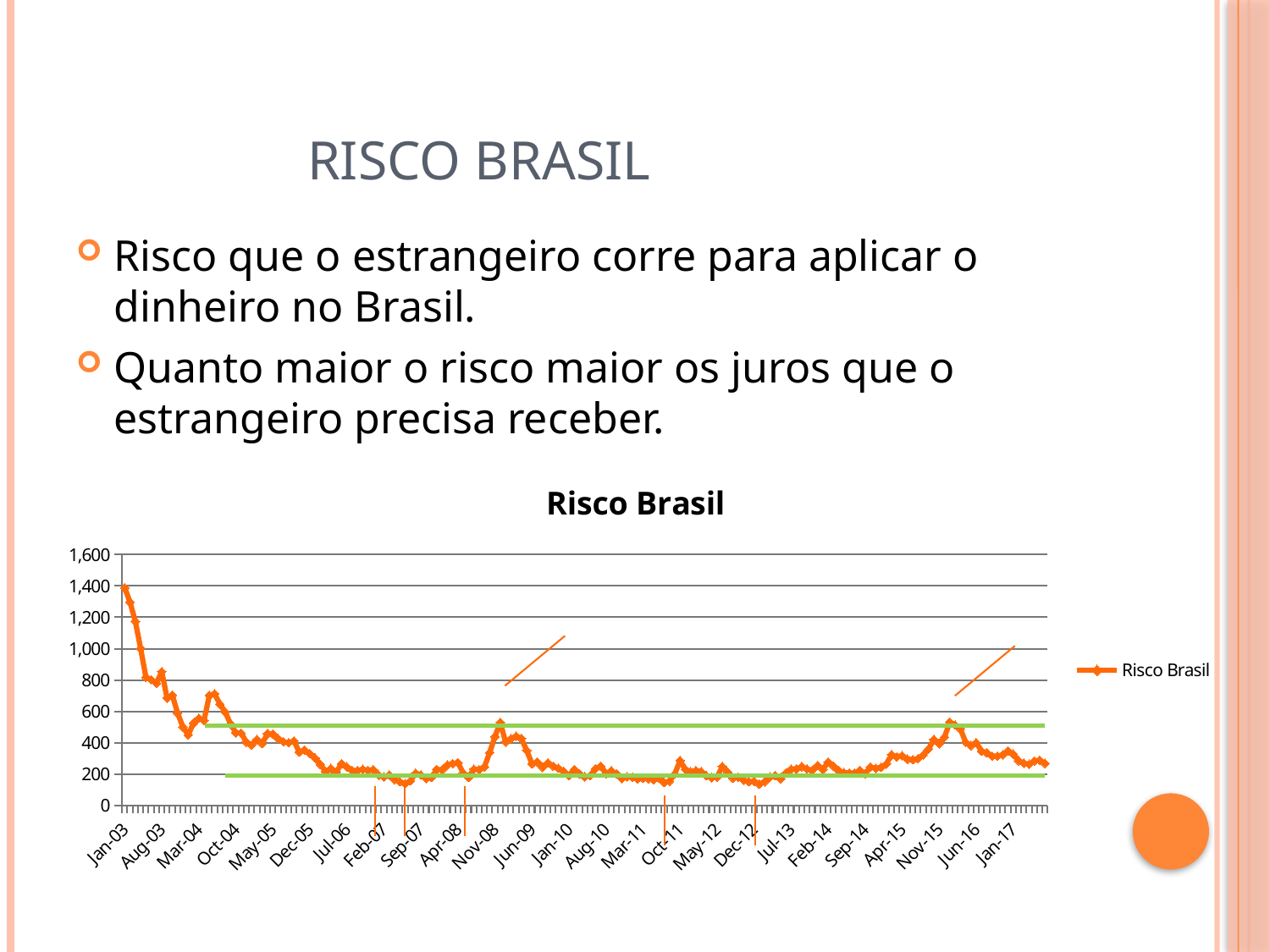
Is the value for Mar-11 greater or less than 400? less What is the title of the chart? Risco Brasil Which is larger, the value for Jan-03 or the value for Jan-17? Jan-03 Does the Risco Brasil series rise or fall between Jan-03 and Jul-06? fall How many series does the legend of the chart list? 1 What kind of chart is shown on the slide? line chart What is the highest value shown on the y axis of the chart? 1,600 At which x-axis label does the Risco Brasil series reach its highest value? Jan-03 What is the name of the series shown in the legend? Risco Brasil Is the value for Jan-17 greater or less than 400? less Is the value for Jan-03 greater or less than 1,200? greater